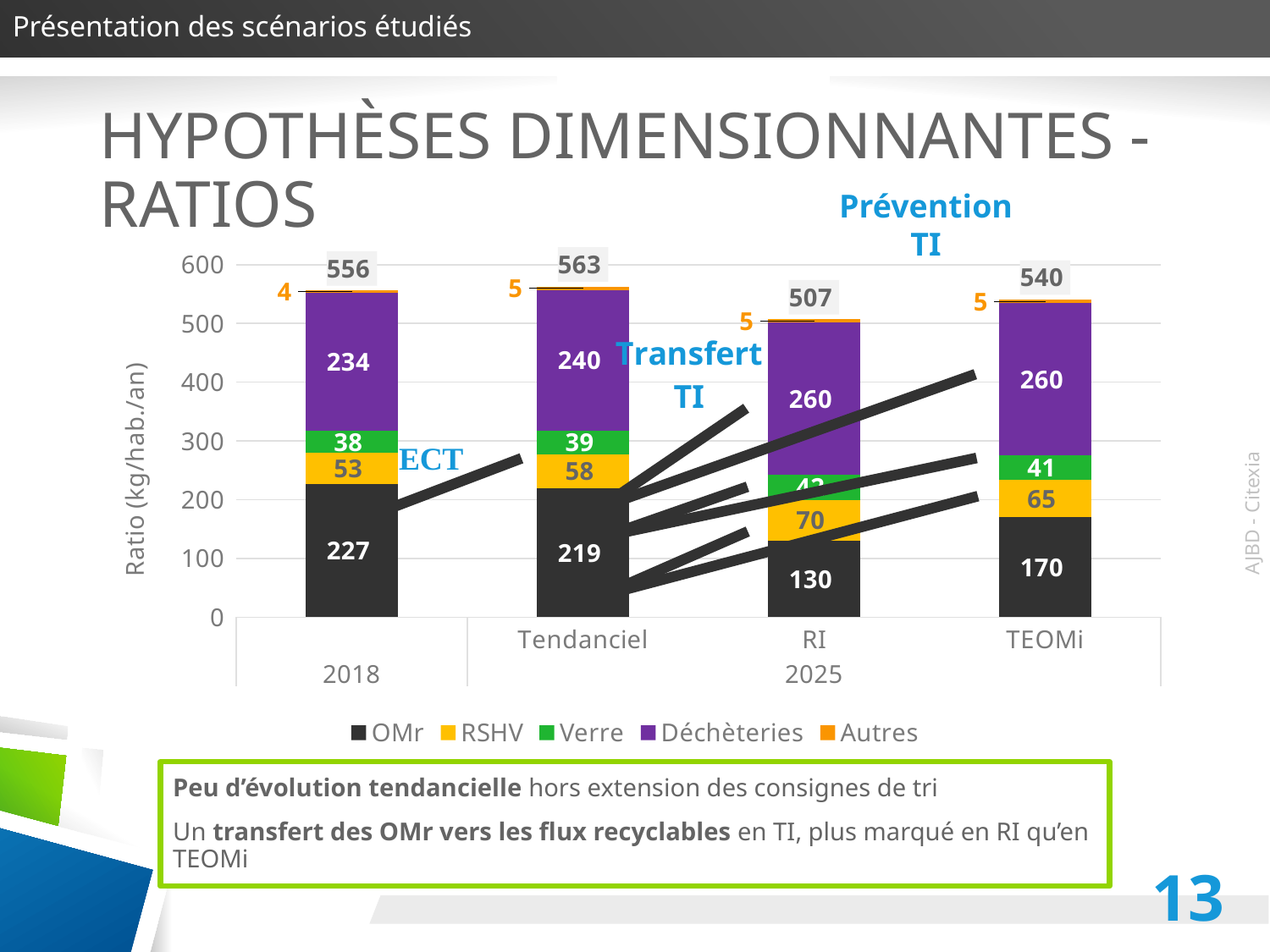
How many stacked bars are plotted in the chart? 4 What is the Déchèteries value for the TEOMi scenario? 260 What kind of chart is shown on the slide? stacked bar chart Which is larger, the Verre value for Tendanciel or the Verre value for TEOMi? TEOMi What is the label of the y axis? Ratio (kg/hab./an) Which bar has the lowest total? RI What is the RSHV value for the RI scenario? 70 Which bar has the highest total? Tendanciel What is the total of the Tendanciel stacked bar? 563 What is the OMr value for the 2018 bar? 227 What is the difference between the OMr value for 2018 and the OMr value for RI? 97 How many series does the legend list? 5